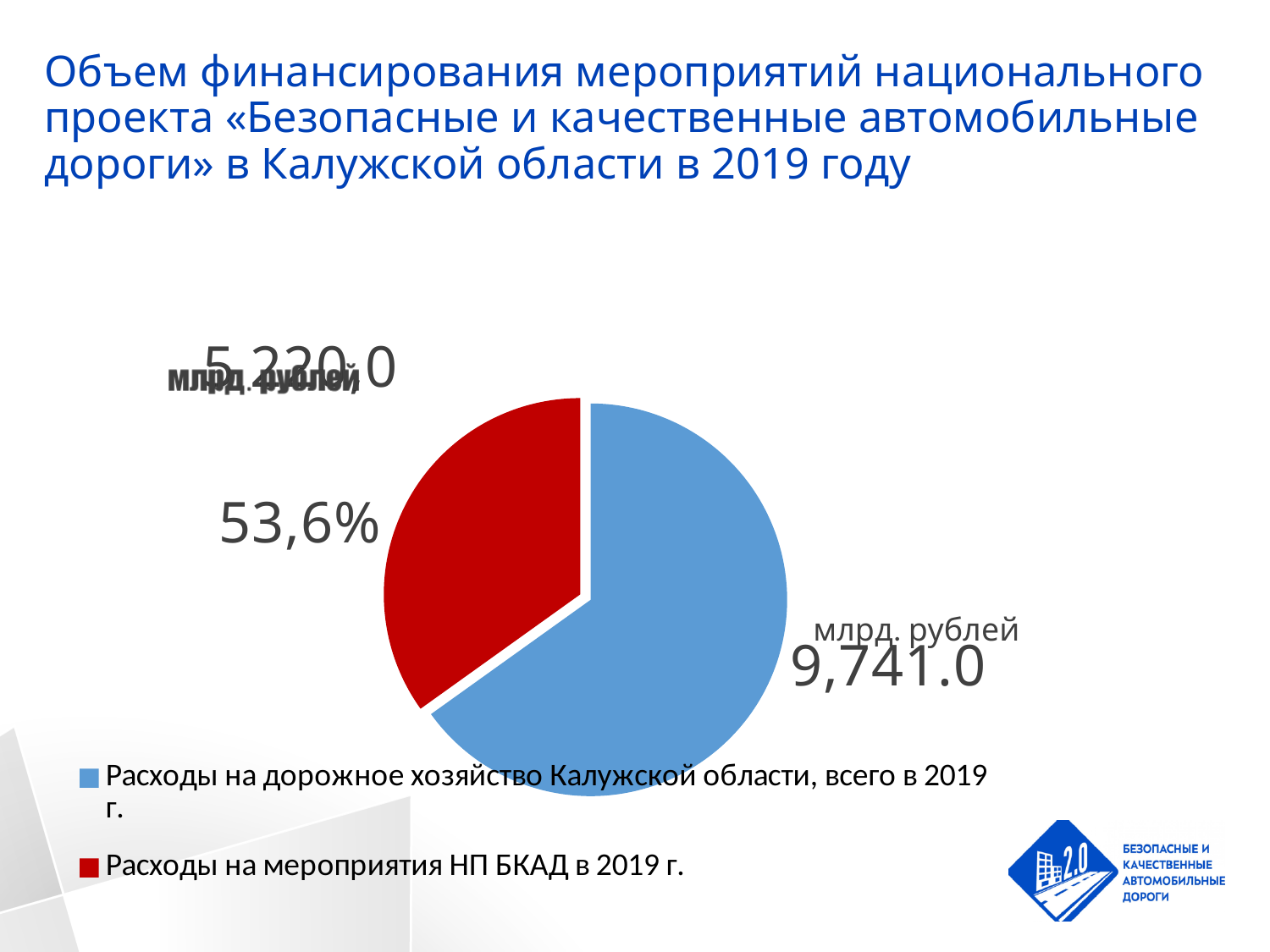
Which is larger: «Расходы на дорожное хозяйство Калужской области, всего в 2019 г.» or «Расходы на мероприятия НП БКАД в 2019 г.»? Расходы на дорожное хозяйство Калужской области, всего в 2019 г. How many slices does the pie chart have? 2 Which slice of the pie chart is the smallest? Расходы на мероприятия НП БКАД в 2019 г. What value is shown for the slice «Расходы на дорожное хозяйство Калужской области, всего в 2019 г.»? 9,741.0 Which slice of the pie chart is the largest? Расходы на дорожное хозяйство Калужской области, всего в 2019 г. What percentage label is printed next to the red slice of the pie chart? 53,6% How many entries does the legend of the pie chart list? 2 What value is shown for the slice «Расходы на мероприятия НП БКАД в 2019 г.»? 5,220.0 What colour is the slice for «Расходы на мероприятия НП БКАД в 2019 г.»? red What kind of chart is shown on the slide? pie chart In what units are the values on the pie chart given? млрд. рублей